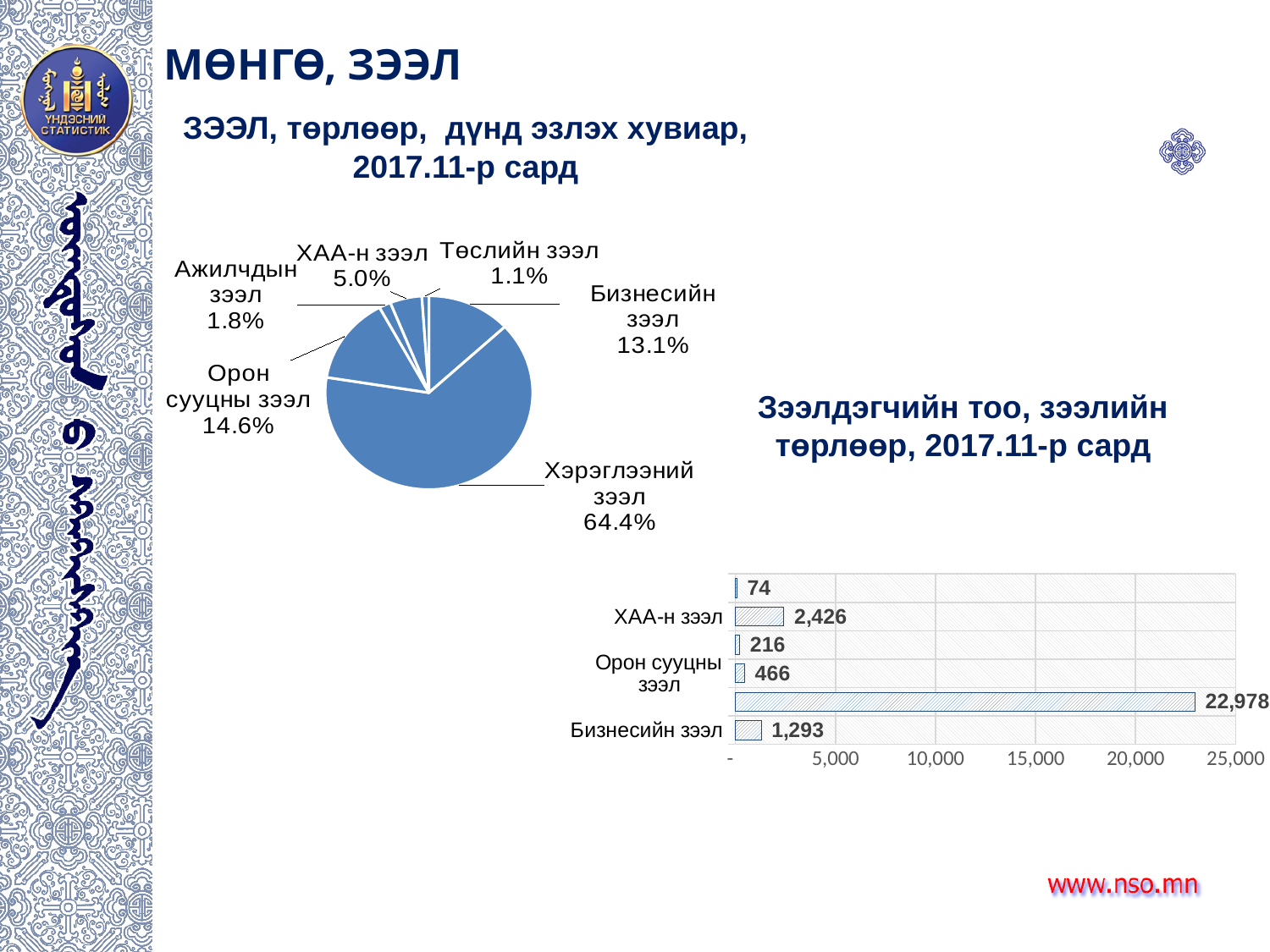
In the pie chart, what is the difference between the shares of Хэрэглээний зээл and Орон суучны зээл? 49.8% What type of chart is the chart titled "ЗЭЭЛ, төрлөөр, дүнд эзлэх хувиар, 2017.11-р сард"? Pie chart In the bar chart "Зээлдэгчийн тоо, зээлийн төрлөөр, 2017.11-р сард", what is the value for ХАА-н зээл? 2,426 In the pie chart, what share does Хэрэглээний зээл have? 64.4% In the pie chart, which is larger: Орон суучны зээл or Бизнесийн зээл? Орон суучны зээл In the pie chart, which category has the largest share? Хэрэглээний зээл In the pie chart, what is the percentage for Орон суучны зээл? 14.6% In the pie chart, how many slices are there? 6 In the pie chart, which category has the smallest share? Төслийн зээл In the bar chart "Зээлдэгчийн тоо, зээлийн төрлөөр, 2017.11-р сард", what is the value for Бизнесийн зээл? 1,293 In the bar chart "Зээлдэгчийн тоо, зээлийн төрлөөр, 2017.11-р сард", what is the difference between the values for ХАА-н зээл and Бизнесийн зээл? 1,133 What type of chart is the chart titled "Зээлдэгчийн тоо, зээлийн төрлөөр, 2017.11-р сард"? Bar chart